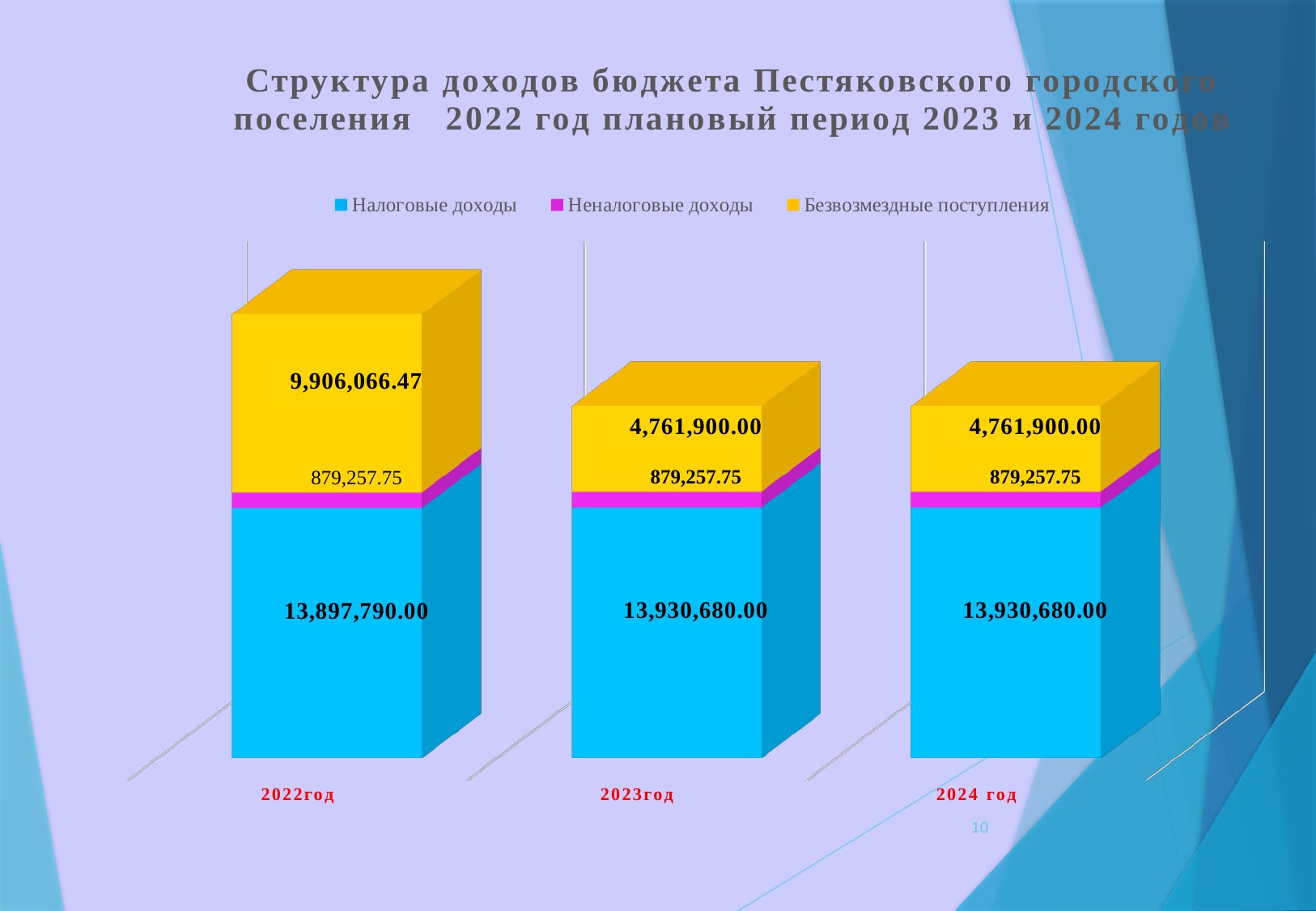
Which series is shown in yellow in the legend? Безвозмездные поступления Which year has the highest value of Безвозмездные поступления? 2022год What is the total of the stacked bar for 2022год? 24,683,114.22 What is the difference between Безвозмездные поступления in 2022год and 2023год? 5,144,166.47 How many series does the legend list? 3 What is the value of Безвозмездные поступления for 2023год? 4,761,900.00 What is the value of Безвозмездные поступления for 2022год? 9,906,066.47 What is the difference between Налоговые доходы in 2023год and 2022год? 32,890.00 What type of chart is shown on the slide? Stacked bar chart What is the value of Неналоговые доходы for 2024 год? 879,257.75 How many categories (years) are shown on the x axis? 3 What is the value of Налоговые доходы for 2022год? 13,897,790.00